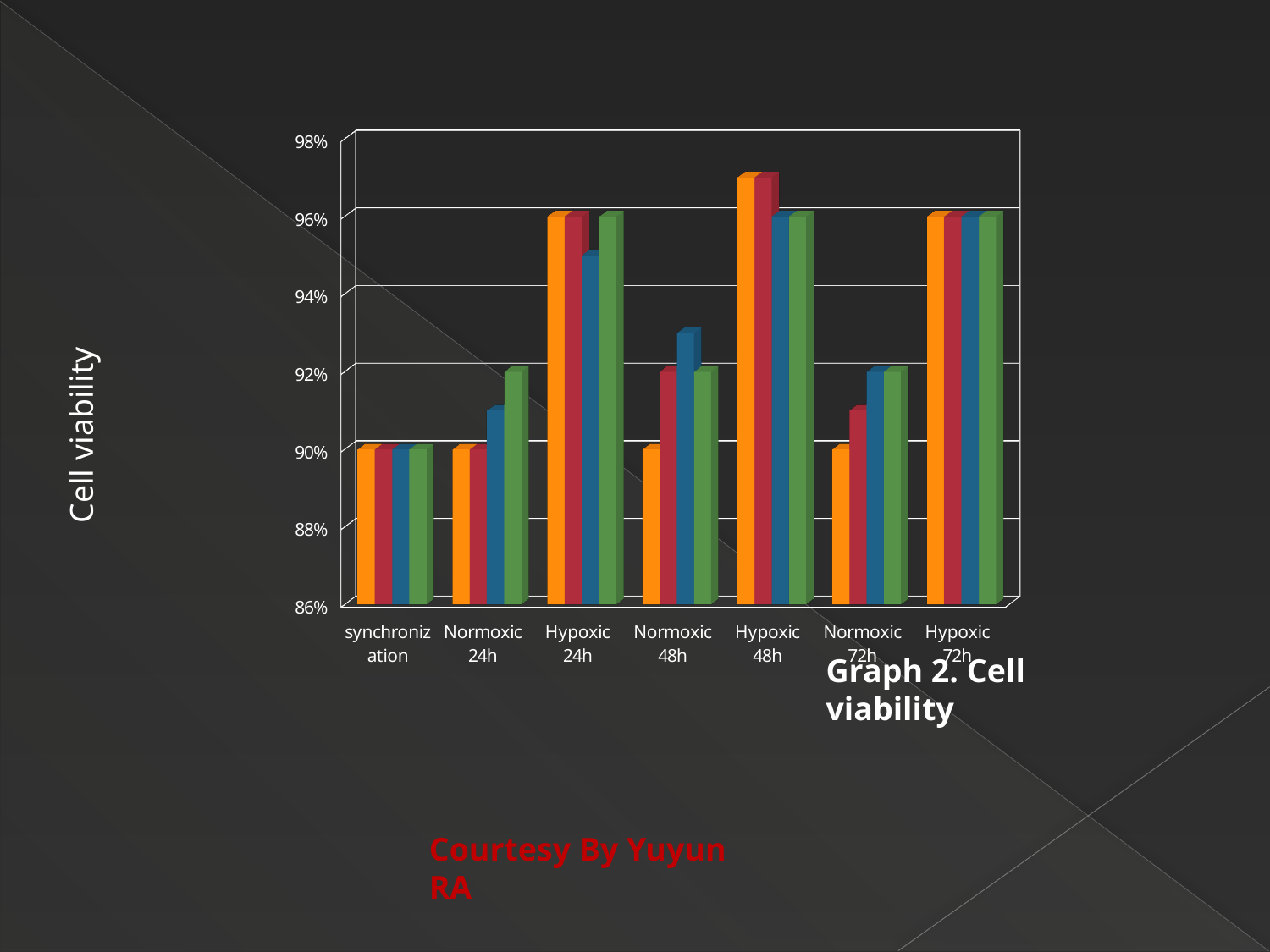
Which category contains the tallest bar in the chart? Hypoxic 48h Is the blue bar for Normoxic 48h greater or less than 92%? greater How many bars are plotted for each category in the chart? 4 Is the blue bar for Normoxic 24h greater or less than 92%? less Which is larger, the orange bar for Hypoxic 24h or the orange bar for Normoxic 24h? Hypoxic 24h What is the label on the vertical axis of the chart? Cell viability What is the caption given for the chart on the slide? Graph 2. Cell viability What kind of chart is shown on the slide? bar chart How many categories are shown on the x axis of the chart? 7 Which is larger, the green bar for Hypoxic 72h or the green bar for Normoxic 72h? Hypoxic 72h Is the orange bar for Hypoxic 48h greater or less than 96%? greater